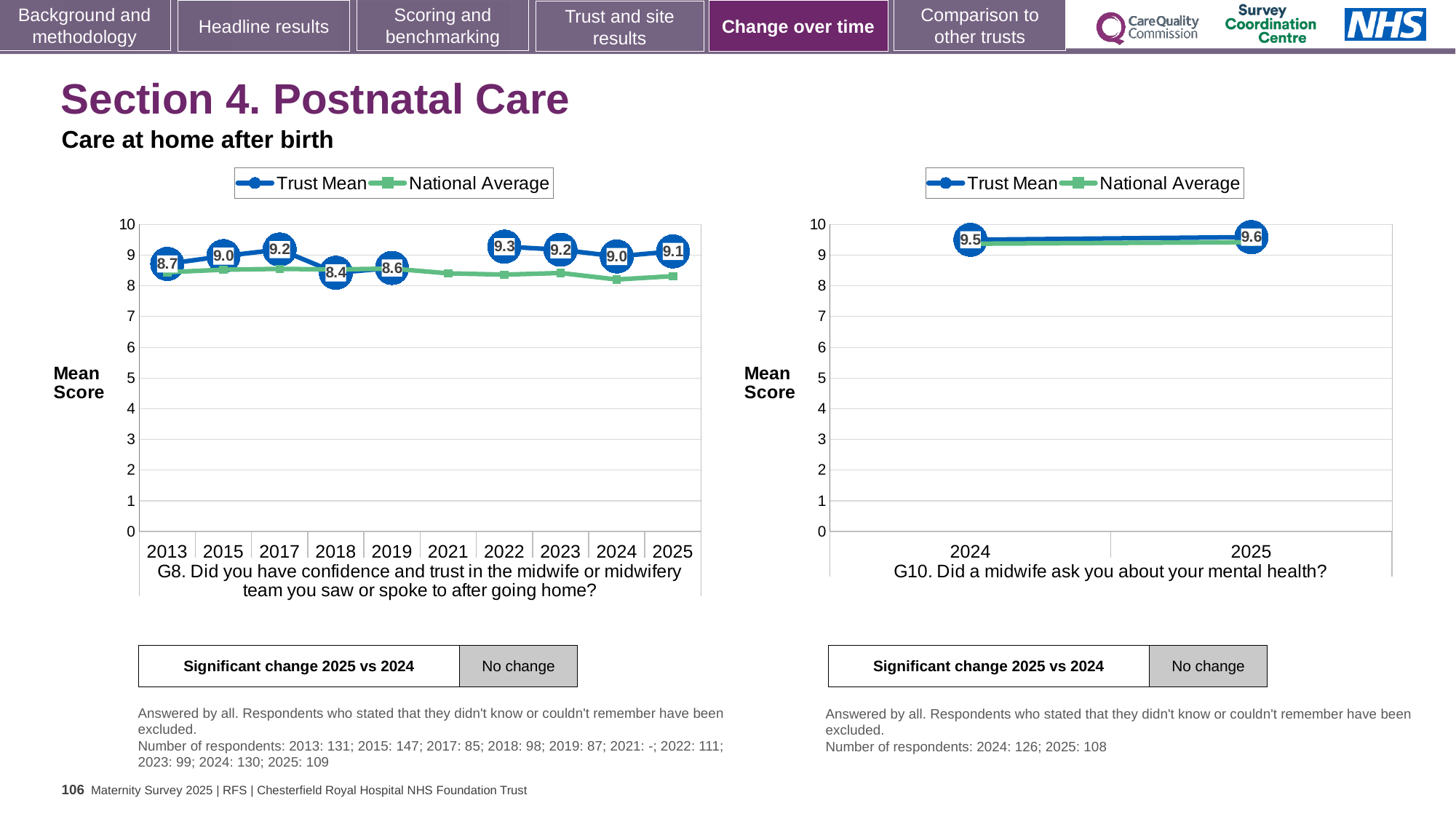
How many years are shown on the x axis of the left chart (G8)? 10 How many series does the legend of the right chart (G10) list? 2 On the left chart (G8), which year has the lowest Trust Mean? 2018 On the left chart (G8), which year has the highest Trust Mean? 2022 On the right chart (G10), what is the Trust Mean for 2025? 9.6 On the left chart (G8), what is the difference between the Trust Mean in 2025 and in 2024? 0.1 On the right chart (G10), does the Trust Mean rise or fall from 2024 to 2025? Rise On the left chart (G8), what is the Trust Mean for 2018? 8.4 On the right chart (G10), is the Trust Mean higher in 2024 or 2025? 2025 On the left chart (G8), is the National Average for 2025 greater or less than 9? less On the left chart (G8), what is the Trust Mean for 2022? 9.3 What kind of chart is the right chart (G10)? Line chart